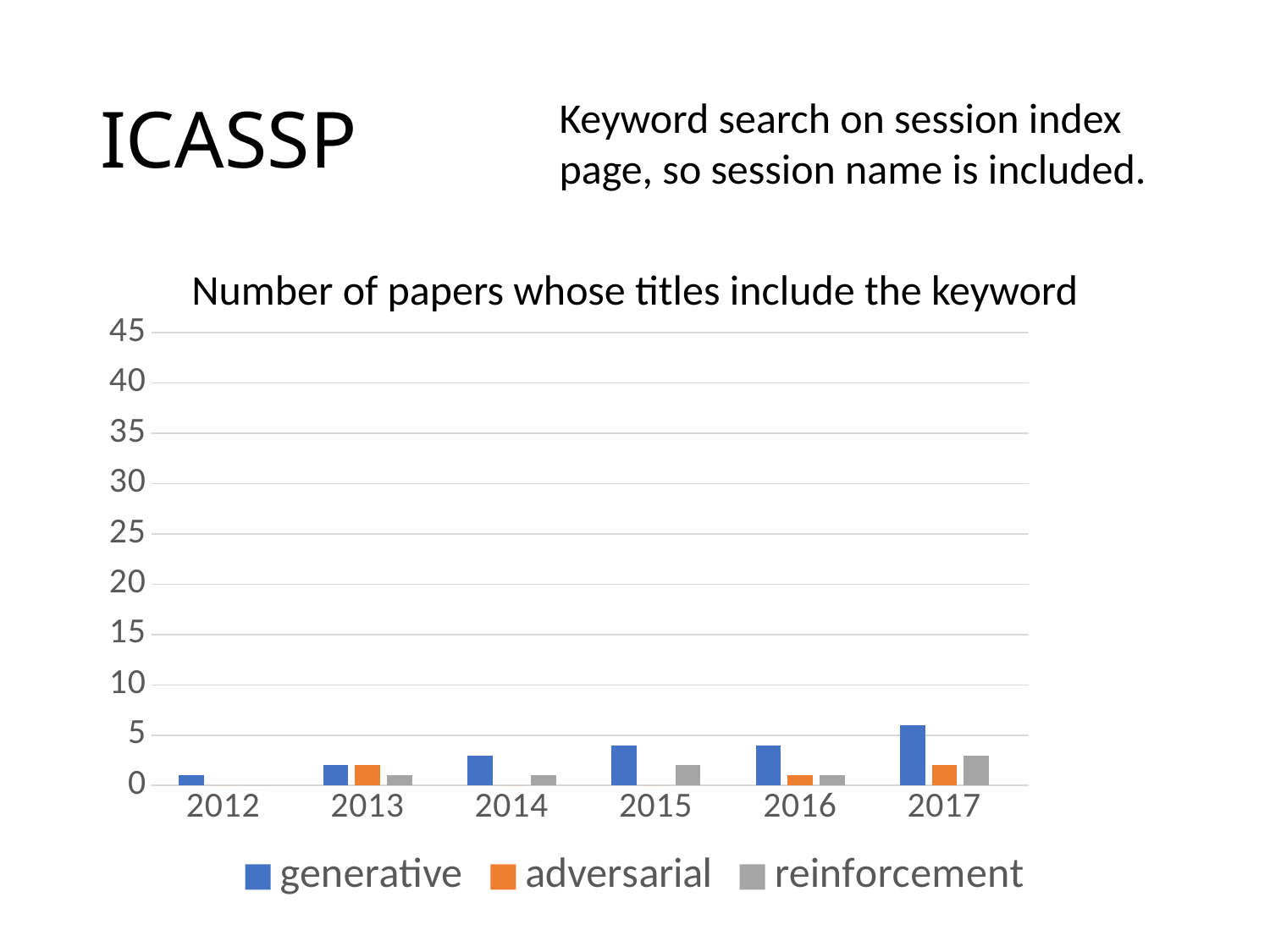
Is the generative value for 2012 greater or less than 5? less Which series is shown in orange? adversarial What is the title of the chart? Number of papers whose titles include the keyword How many years are shown on the x axis? 6 In which year is the generative series highest? 2017 Is the reinforcement value for 2017 greater or less than 5? less Does the generative series generally rise or fall from 2012 to 2017? rise In which year is the generative series lowest? 2012 Is the generative value for 2017 greater or less than 10? less What kind of chart is shown on the slide? bar chart Which is larger, the generative value for 2017 or the generative value for 2012? 2017 How many series does the legend list? 3